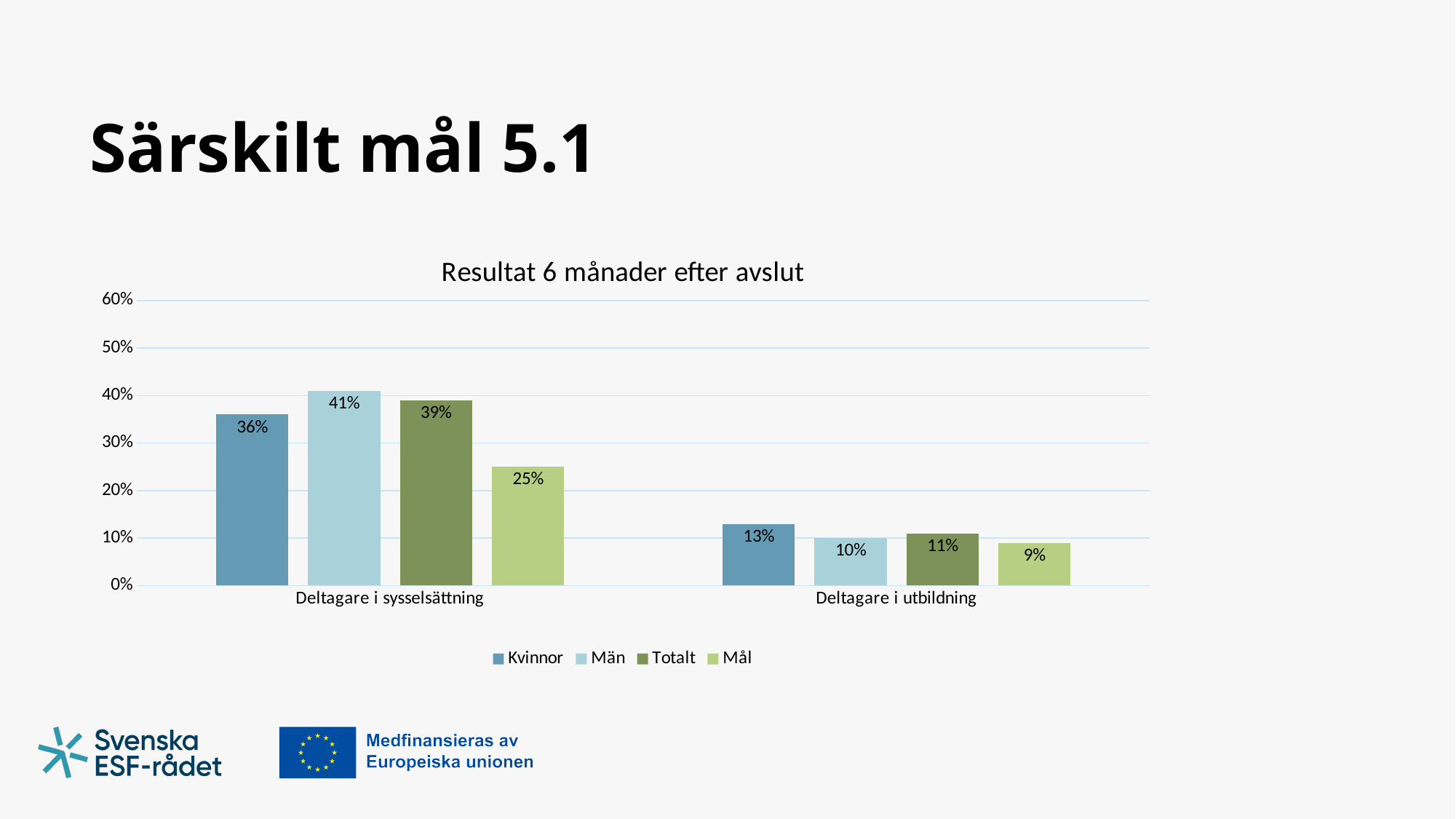
What is the value for Kvinnor in the Deltagare i utbildning category? 13% What is the title of the chart? Resultat 6 månader efter avslut What is the value for Mål in the Deltagare i utbildning category? 9% What kind of chart is shown on the slide? Bar chart What is the difference between the Kvinnor value and the Män value for Deltagare i utbildning? 3% What is the difference between the Totalt value and the Mål value for Deltagare i sysselsättning? 14% Which series has the highest value in the Deltagare i sysselsättning category? Män Which series has the lowest value in the Deltagare i utbildning category? Mål How many categories are shown on the x axis? 2 How many series does the legend list? 4 Which is larger for Deltagare i sysselsättning: the Kvinnor value or the Män value? Män What is the value for Män in the Deltagare i sysselsättning category? 41%